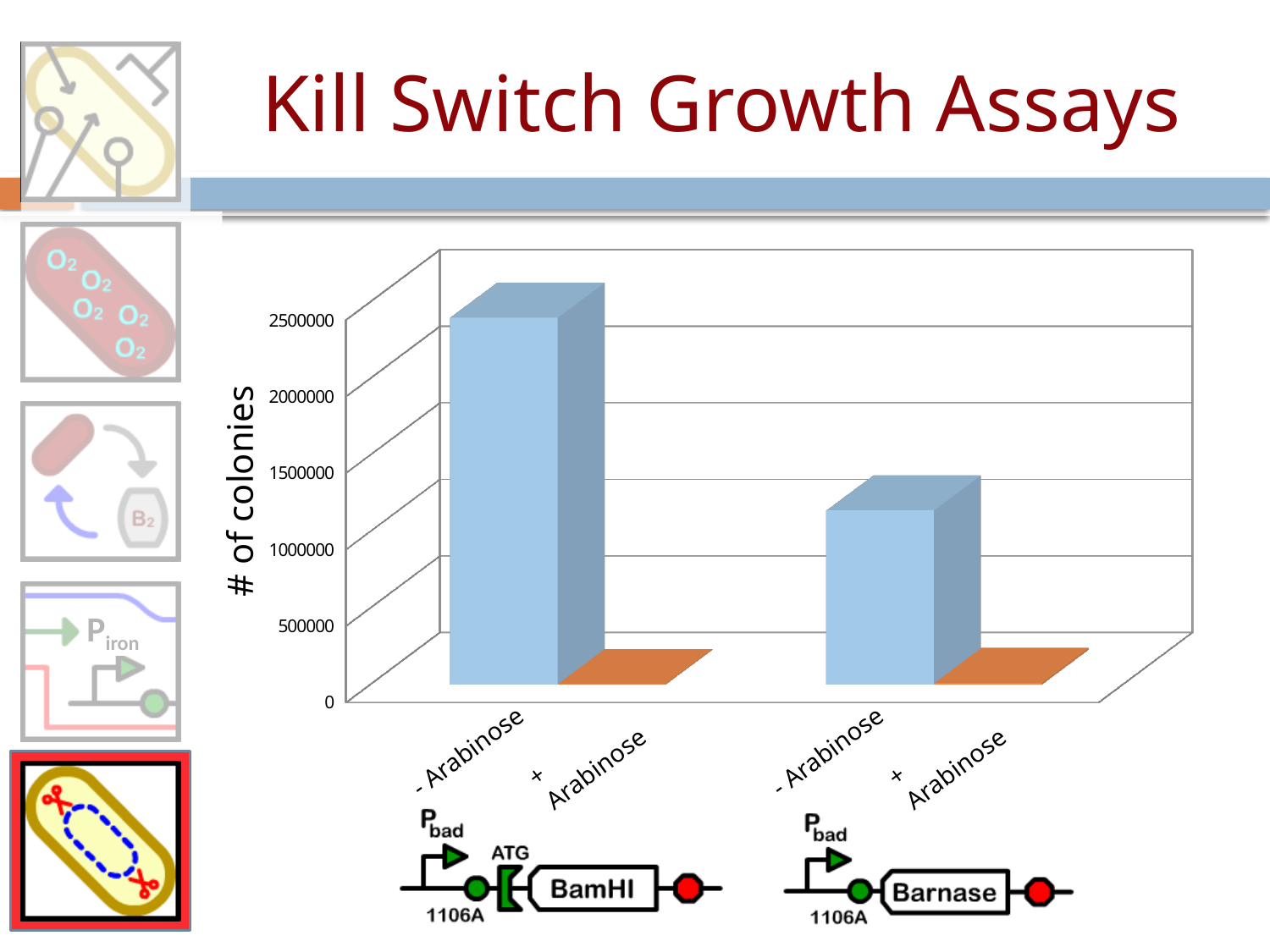
What is the highest value shown on the vertical axis of the chart? 2500000 Which is larger: the number of colonies for BamHI - Arabinose or for Barnase - Arabinose? BamHI - Arabinose What kind of chart is shown on the slide? bar chart What is the title of the slide containing the chart? Kill Switch Growth Assays Is the number of colonies for the BamHI + Arabinose condition greater or less than 500000? less Is the number of colonies for the BamHI - Arabinose condition greater or less than 2000000? greater Which category has the highest number of colonies? - Arabinose (BamHI) How many categories are shown along the x axis of the chart? 4 Is the number of colonies for the Barnase - Arabinose condition greater or less than 1500000? less What is the label of the vertical axis of the chart? # of colonies Which is larger: the number of colonies for Barnase - Arabinose or for Barnase + Arabinose? Barnase - Arabinose